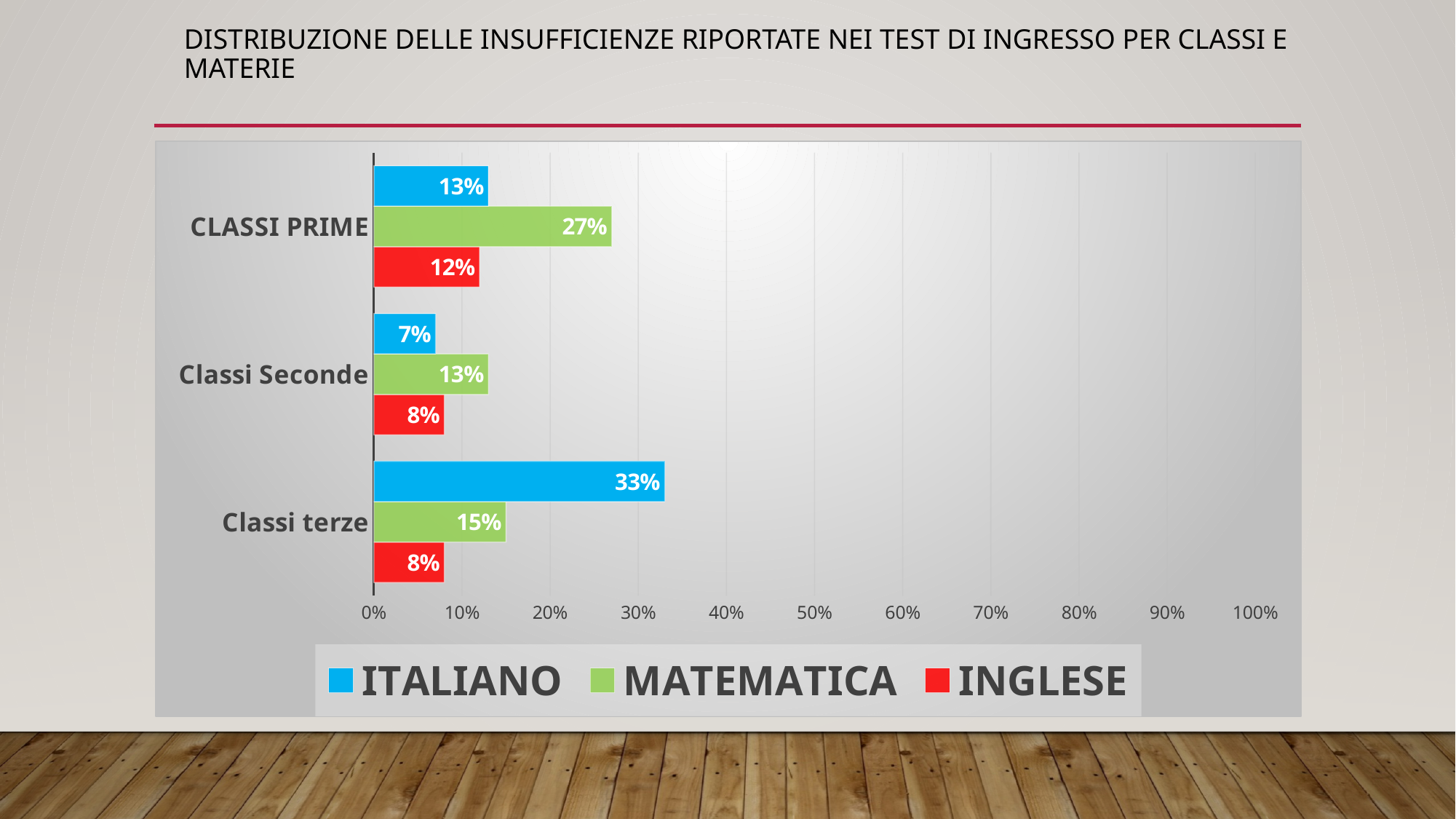
What is the value for INGLESE in Classi terze? 8% What is the difference between the ITALIANO value for Classi terze and the ITALIANO value for Classi Seconde? 26% Which subject has the lowest value in Classi Seconde? ITALIANO Which is larger: MATEMATICA in CLASSI PRIME or MATEMATICA in Classi terze? MATEMATICA in CLASSI PRIME What kind of chart is shown on the slide? Bar chart Which subject has the highest value in CLASSI PRIME? MATEMATICA Is the value for ITALIANO in Classi terze greater or less than 30%? greater Which class has the highest value for ITALIANO? Classi terze How many series does the legend list? 3 What is the value for ITALIANO in CLASSI PRIME? 13% What is the value for MATEMATICA in Classi Seconde? 13% How many classes (categories) are shown on the chart? 3